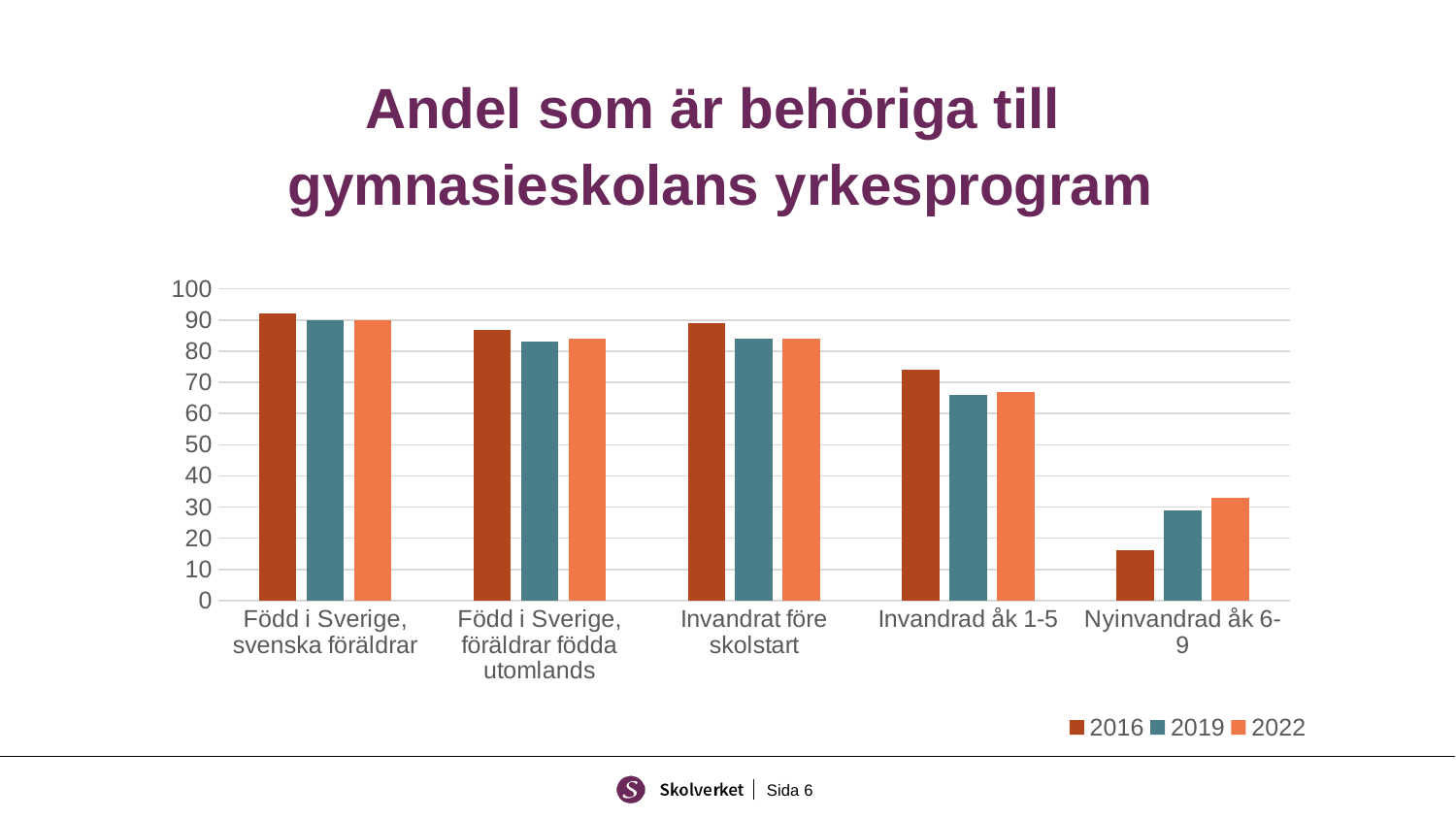
How many categories are shown on the x axis? 5 Do the values for Nyinvandrad åk 6-9 rise or fall from 2016 to 2022? rise What are the entries in the chart's legend? 2016, 2019, 2022 Which category has the lowest value for 2022? Nyinvandrad åk 6-9 What kind of chart is shown on the slide? bar chart Which category has the lowest value for 2016? Nyinvandrad åk 6-9 How many series does the legend list? 3 Is the 2016 value for Nyinvandrad åk 6-9 greater or less than 20? less Is the 2019 value for Invandrad åk 1-5 greater or less than 70? less For Invandrad åk 1-5, which is larger: the 2016 value or the 2019 value? 2016 For Nyinvandrad åk 6-9, which is larger: the 2016 value or the 2022 value? 2022 Is the 2016 value for Invandrat före skolstart greater or less than 80? greater